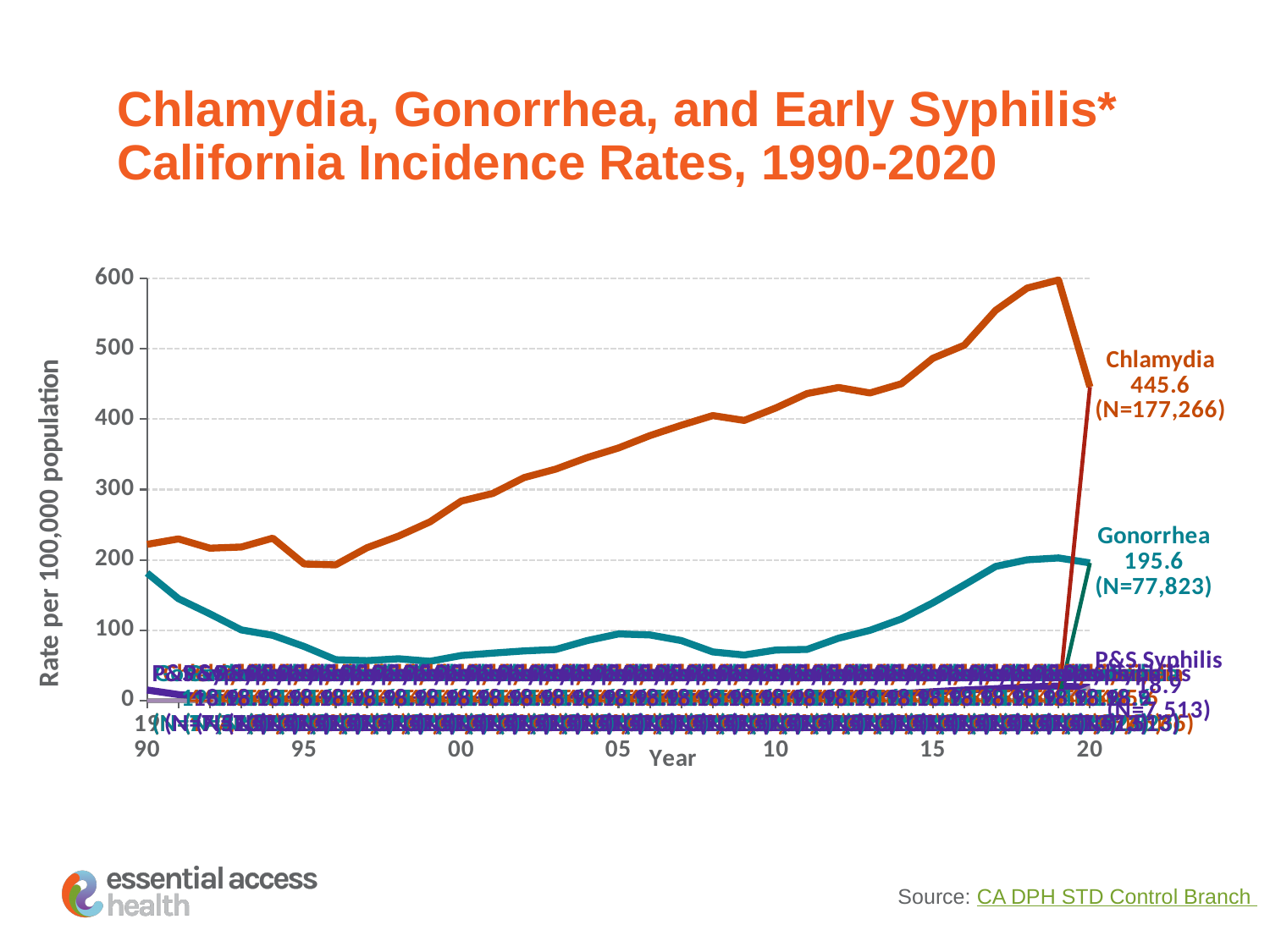
Which has the higher labeled 2020 rate, Chlamydia or Gonorrhea? Chlamydia What is the number of Gonorrhea cases (N) shown in the Gonorrhea label? N=77,823 What is the label on the vertical axis of the chart? Rate per 100,000 population Is the peak value of the Chlamydia line (around 2019) greater or less than 500? greater Does the Chlamydia line generally rise or fall between 1996 and 2019? rise What is the Gonorrhea incidence rate labeled at the end of the line (2020)? 195.6 Is the Chlamydia rate in 1990 greater or less than 200? greater Is the Gonorrhea rate in 1990 greater or less than 200? less What is the number of Chlamydia cases (N) shown in the Chlamydia label? N=177,266 What is the Chlamydia incidence rate labeled at the end of the line (2020)? 445.6 What type of chart is shown on the slide? line chart What is the difference between the labeled 2020 Chlamydia rate and the labeled 2020 Gonorrhea rate? 250.0